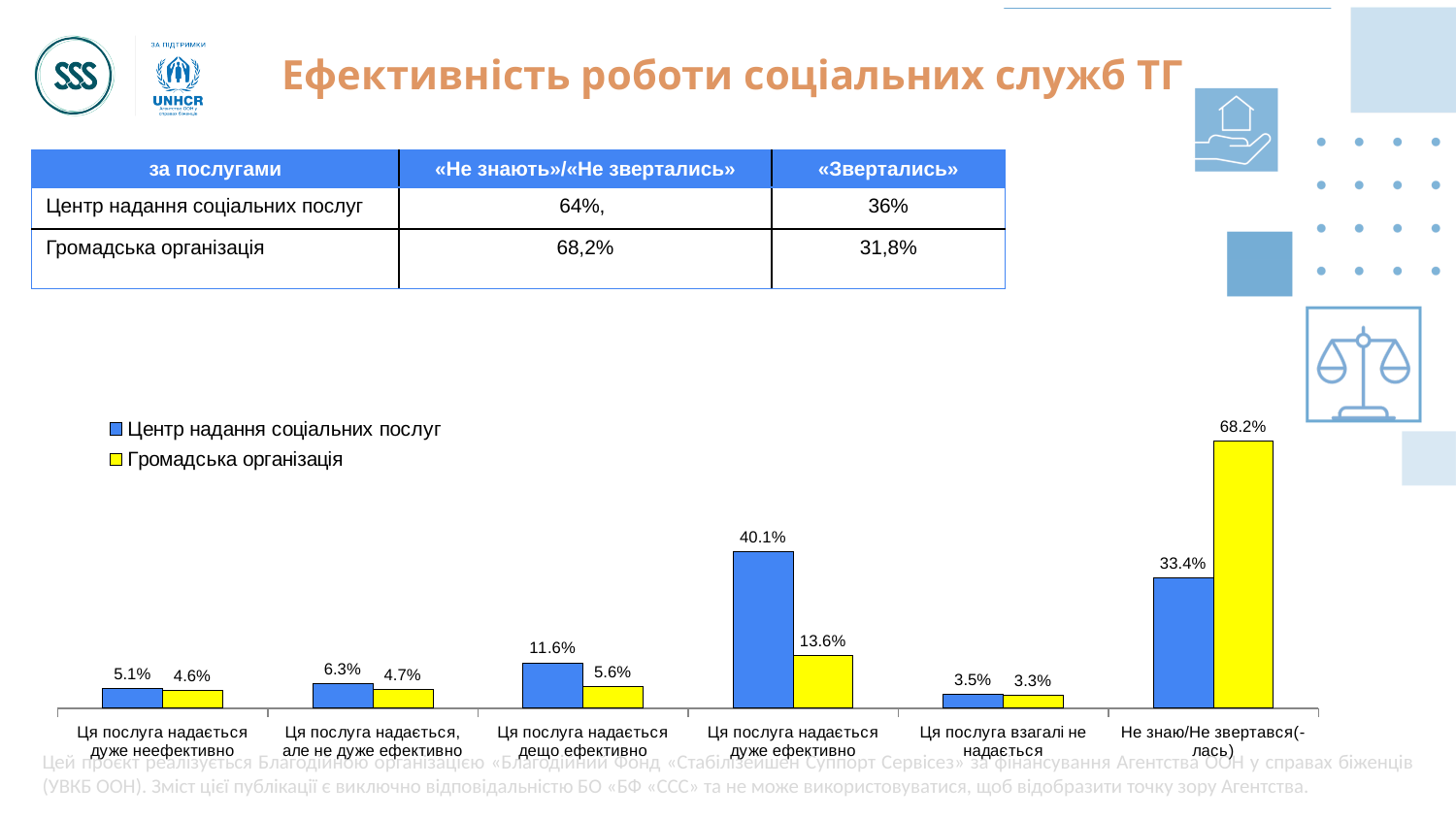
Which colour represents «Громадська організація» in the chart? yellow How many categories are shown on the x axis of the chart? 6 Which category has the lowest value for «Центр надання соціальних послуг»? Ця послуга взагалі не надається In the category «Ця послуга надається дуже ефективно», which series has the larger value? Центр надання соціальних послуг What is the value for «Громадська організація» in the category «Не знаю/Не звертався(-лась)»? 68.2% What is the value for «Центр надання соціальних послуг» in the category «Ця послуга взагалі не надається»? 3.5% What is the difference between «Громадська організація» and «Центр надання соціальних послуг» in the category «Не знаю/Не звертався(-лась)»? 34.8% What is the value for «Громадська організація» in the category «Ця послуга надається дещо ефективно»? 5.6% What type of chart is shown on the slide? bar chart What is the value for «Центр надання соціальних послуг» in the category «Ця послуга надається дуже ефективно»? 40.1% Which category has the highest value for «Громадська організація»? Не знаю/Не звертався(-лась) How many series does the chart legend list? 2